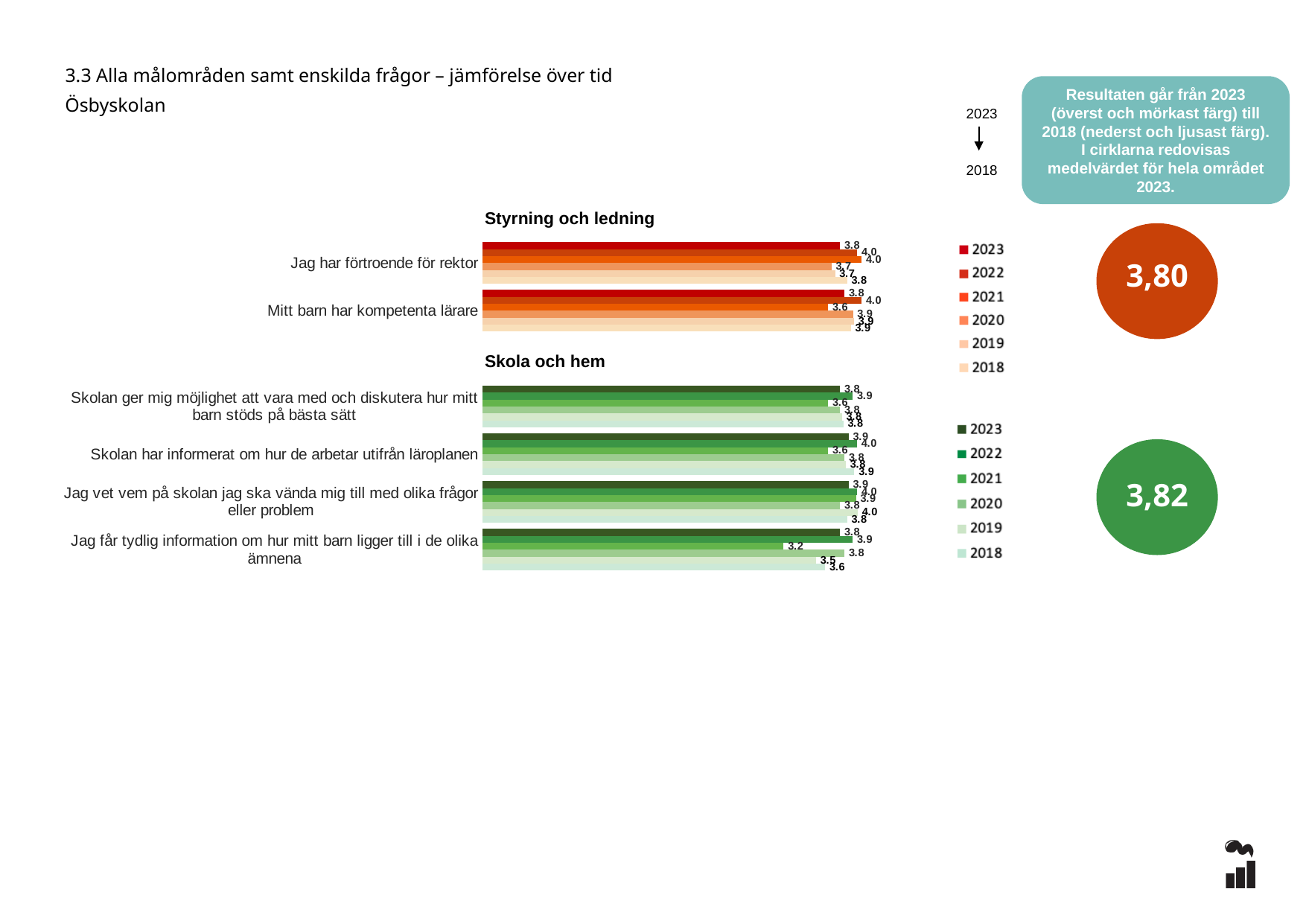
In the "Styrning och ledning" chart, which year has the larger value for "Mitt barn har kompetenta lärare", 2022 or 2021? 2022 How many series does the legend for the "Skola och hem" chart list? 6 What mean value is shown in the green circle next to the "Skola och hem" chart? 3,82 In the "Skola och hem" chart, what is the difference between the 2022 and 2021 values for "Jag får tydlig information om hur mitt barn ligger till i de olika ämnena"? 0.7 In the "Skola och hem" chart, what is the 2021 value for "Jag får tydlig information om hur mitt barn ligger till i de olika ämnena"? 3.2 What kind of chart is used under "Styrning och ledning"? bar chart In the "Styrning och ledning" chart, what is the 2023 value for "Jag har förtroende för rektor"? 3.8 How many questions (categories) are shown in the "Skola och hem" chart? 4 In the "Skola och hem" chart, what is the 2022 value for "Skolan har informerat om hur de arbetar utifrån läroplanen"? 4.0 How many questions (categories) are shown in the "Styrning och ledning" chart? 2 What mean value is shown in the orange circle next to the "Styrning och ledning" chart? 3,80 In the "Skola och hem" chart, which year has the lowest value for "Jag får tydlig information om hur mitt barn ligger till i de olika ämnena"? 2021